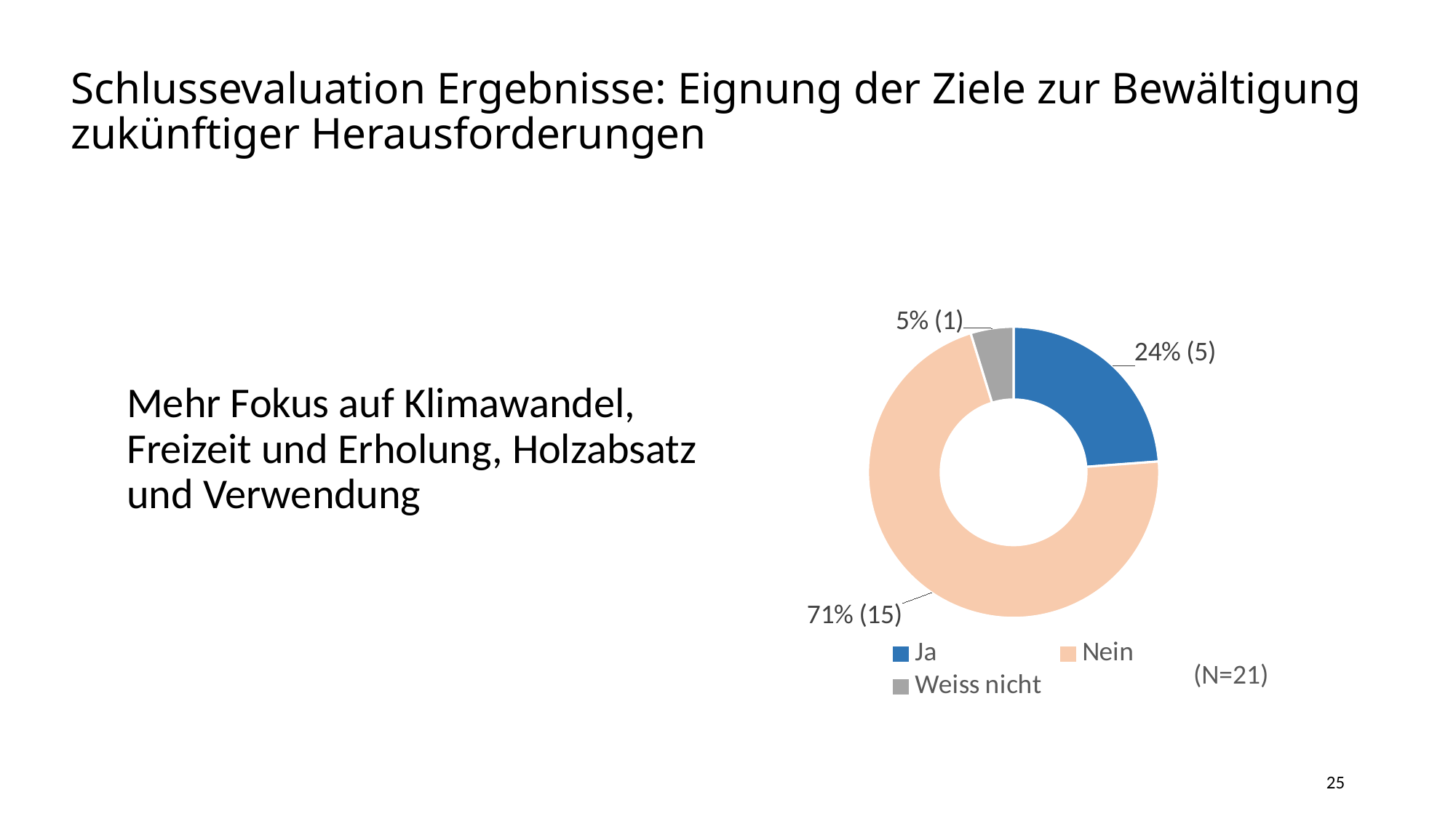
What is the difference in percentage points between the "Nein" and "Ja" shares? 47 percentage points How many categories does the legend list? 3 What percentage of respondents answered "Nein"? 71% What percentage of respondents answered "Ja"? 24% Which answer category has the largest share of the chart? Nein What kind of chart is shown on the slide? Doughnut (pie) chart How many respondents answered "Ja"? 5 Which answer category has the smallest share of the chart? Weiss nicht What is the total number of respondents (N) shown next to the chart? N=21 Which share is larger, "Ja" or "Weiss nicht"? Ja How many respondents answered "Nein"? 15 What percentage of respondents answered "Weiss nicht"? 5%